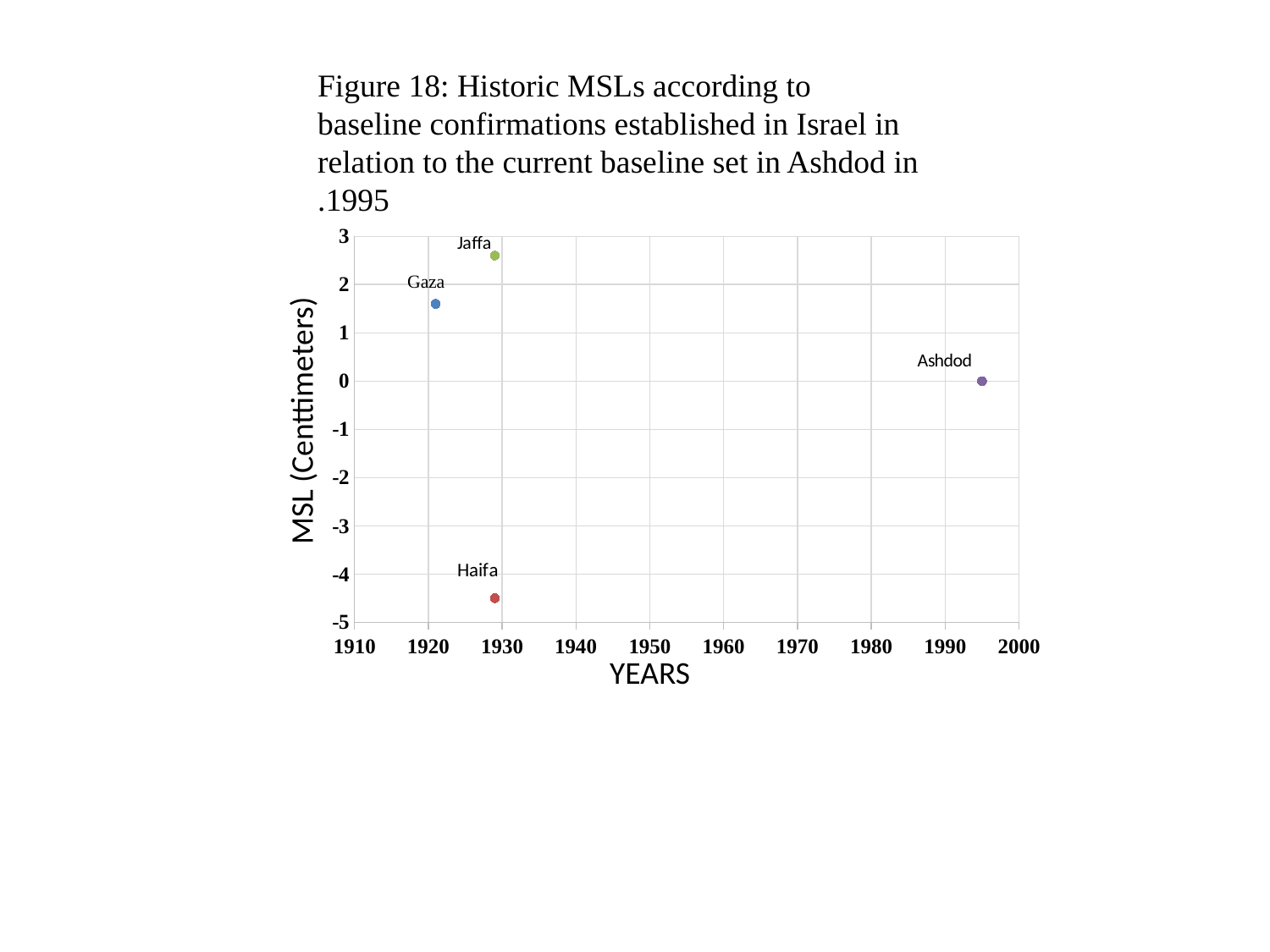
Which has a larger MSL value, Gaza or Haifa? Gaza Is the MSL value for Haifa greater or less than -4? less What is the label of the vertical axis? MSL (Centtimeters) How many data points are plotted on the chart? 4 Which has a larger MSL value, Jaffa or Ashdod? Jaffa What is the MSL value for Ashdod? 0 Which location has the lowest MSL value on the chart? Haifa Is the MSL value for Jaffa greater or less than 2? greater What is the label of the horizontal axis? YEARS Is the MSL value for Gaza greater or less than 1? greater Which location has the highest MSL value on the chart? Jaffa What kind of chart is shown on the slide? scatter chart